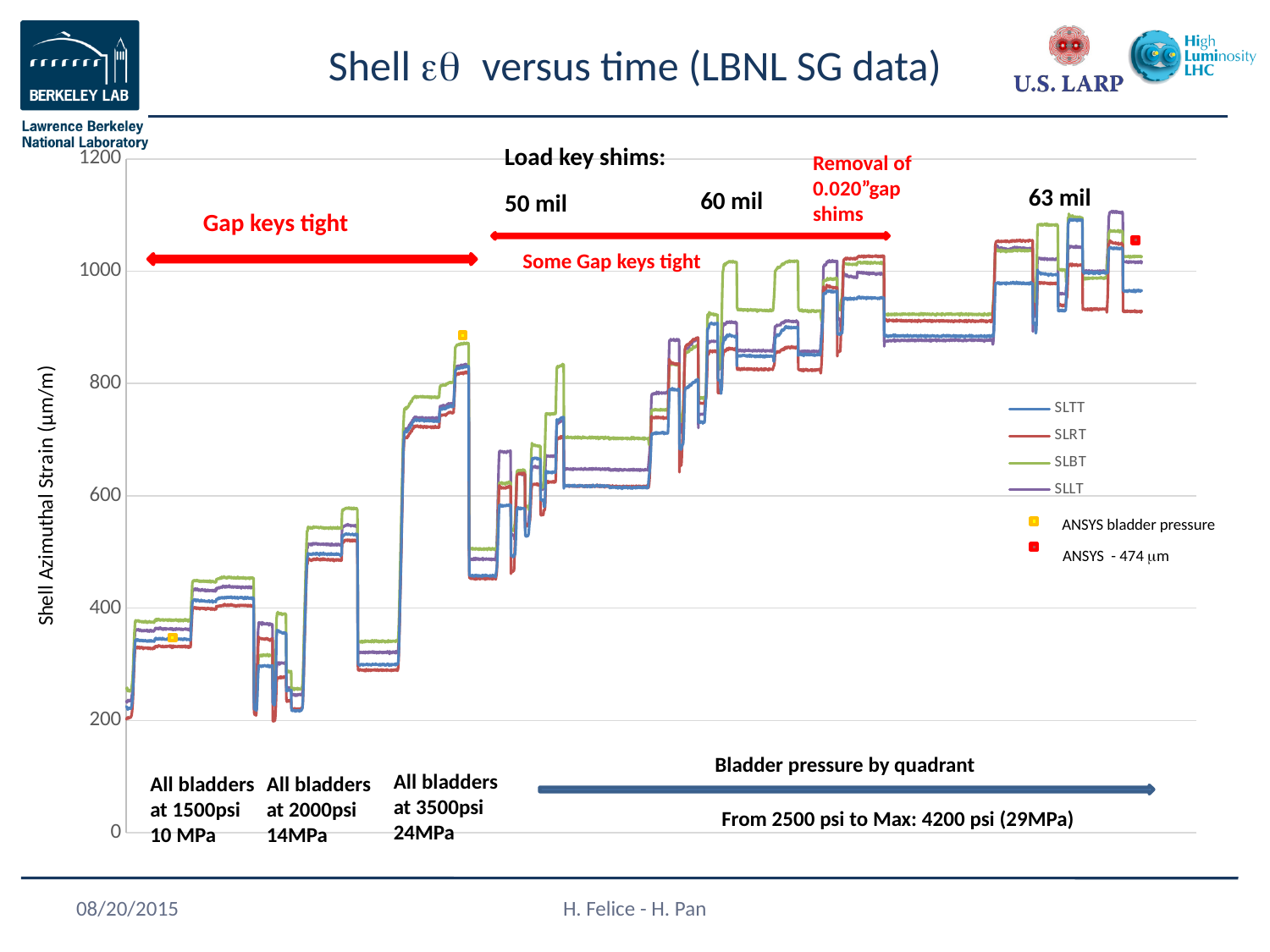
What kind of chart is shown on the slide? line chart What is the title of the chart on the slide? Shell εθ versus time (LBNL SG data) Overall, do the strain values rise or fall from left to right along the x axis? rise What is the label of the vertical axis? Shell Azimuthal Strain (μm/m) Is the value of the ANSYS bladder pressure marker near the middle of the chart greater or less than 800? greater Is the value of the SLLT series at the far right end of the chart greater or less than 1200? less Is the highest value reached by the SLBT series greater or less than 1000? greater How many entries does the chart legend list? 6 What is the maximum value shown on the vertical axis? 1200